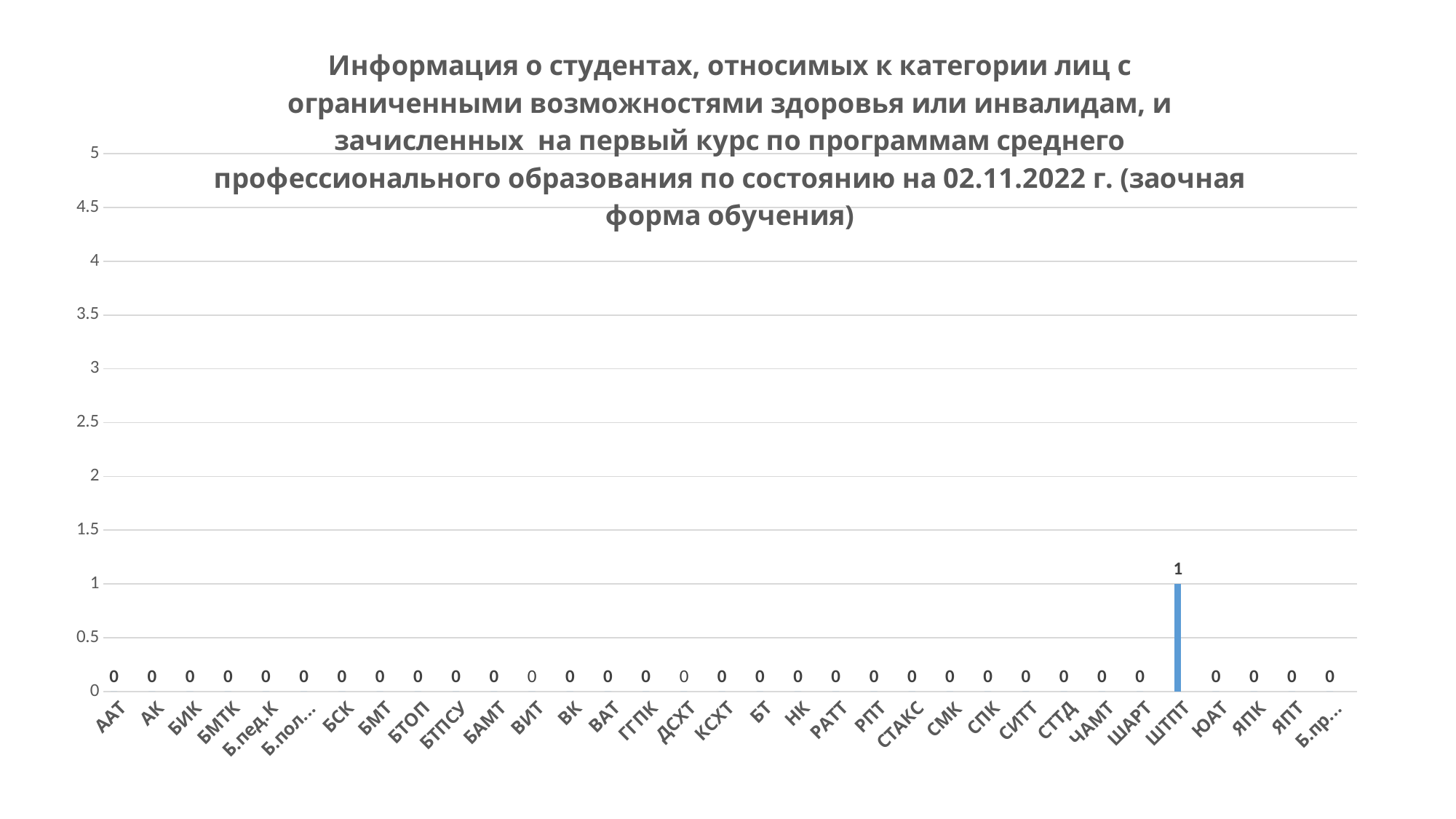
What is the value for СПК? 0 What is the value for ААТ? 0 What is the value for ШТПТ? 1 What colour is the bar for ШТПТ? blue How many categories are shown on the x axis? 33 Which category has the highest value? ШТПТ What is the difference between the values for ШТПТ and ЮАТ? 1 How many categories have a value of 1? 1 What is the maximum value shown on the vertical axis? 5 What type of chart is shown on the slide? bar chart Is the value for ШТПТ greater or less than 2? less Which is larger, the value for ШТПТ or the value for ШАРТ? ШТПТ